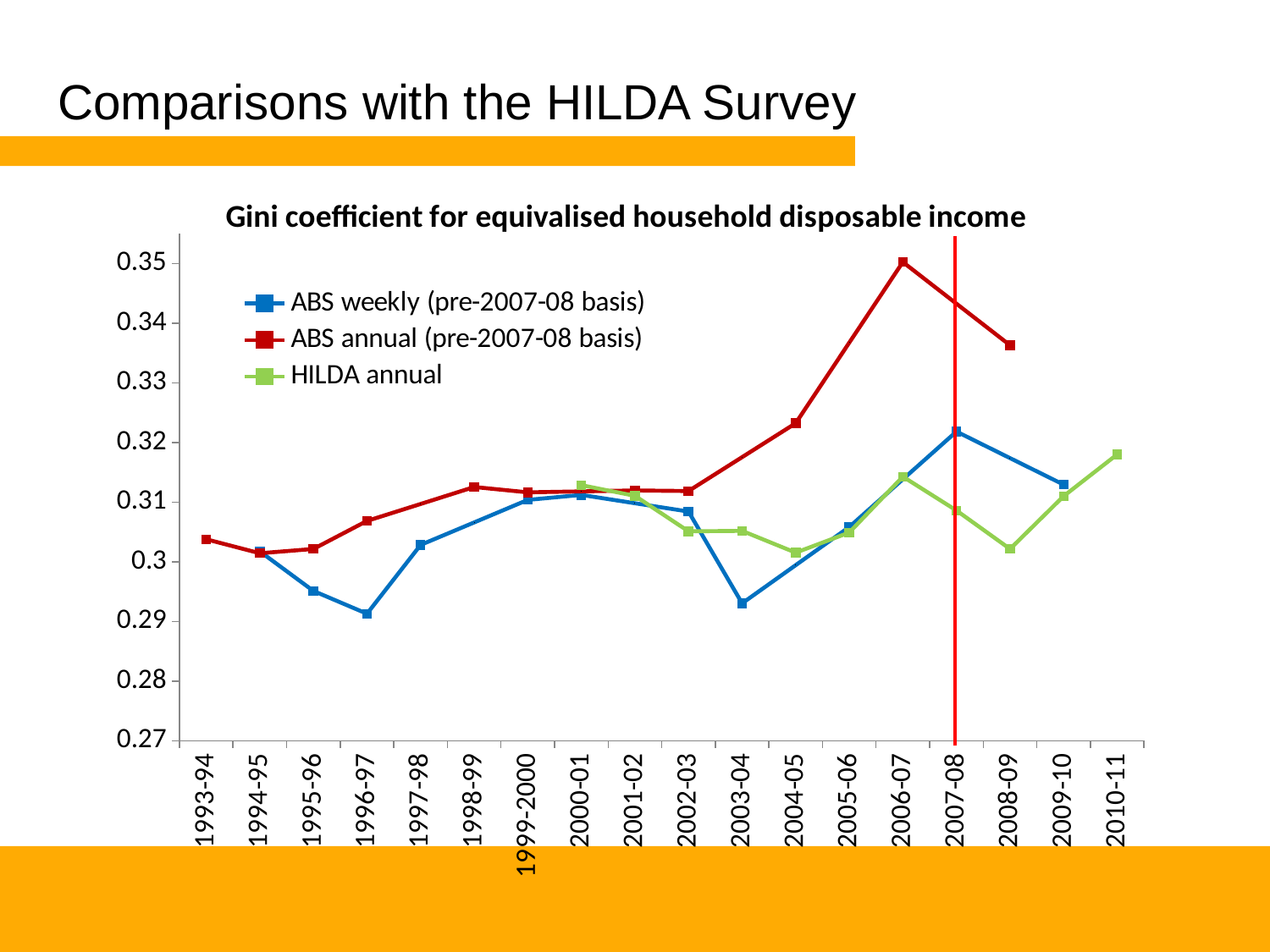
How many year categories are shown on the x axis? 18 Which series is drawn in red? ABS annual (pre-2007-08 basis) In 2003-04, which is higher: ABS annual (pre-2007-08 basis) or ABS weekly (pre-2007-08 basis)? ABS annual (pre-2007-08 basis) How many series does the legend list? 3 What kind of chart is shown on the slide? line chart Is the value for ABS weekly (pre-2007-08 basis) in 1996-97 greater or less than 0.3? less Is the value for ABS annual (pre-2007-08 basis) in 2006-07 greater or less than 0.34? greater Does the ABS annual (pre-2007-08 basis) series rise or fall between 2002-03 and 2006-07? rise In which year does the ABS weekly (pre-2007-08 basis) series reach its lowest value? 1996-97 In which year does the ABS annual (pre-2007-08 basis) series reach its highest value? 2006-07 Is the value for HILDA annual in 2008-09 greater or less than 0.31? less What is the title of the chart? Gini coefficient for equivalised household disposable income